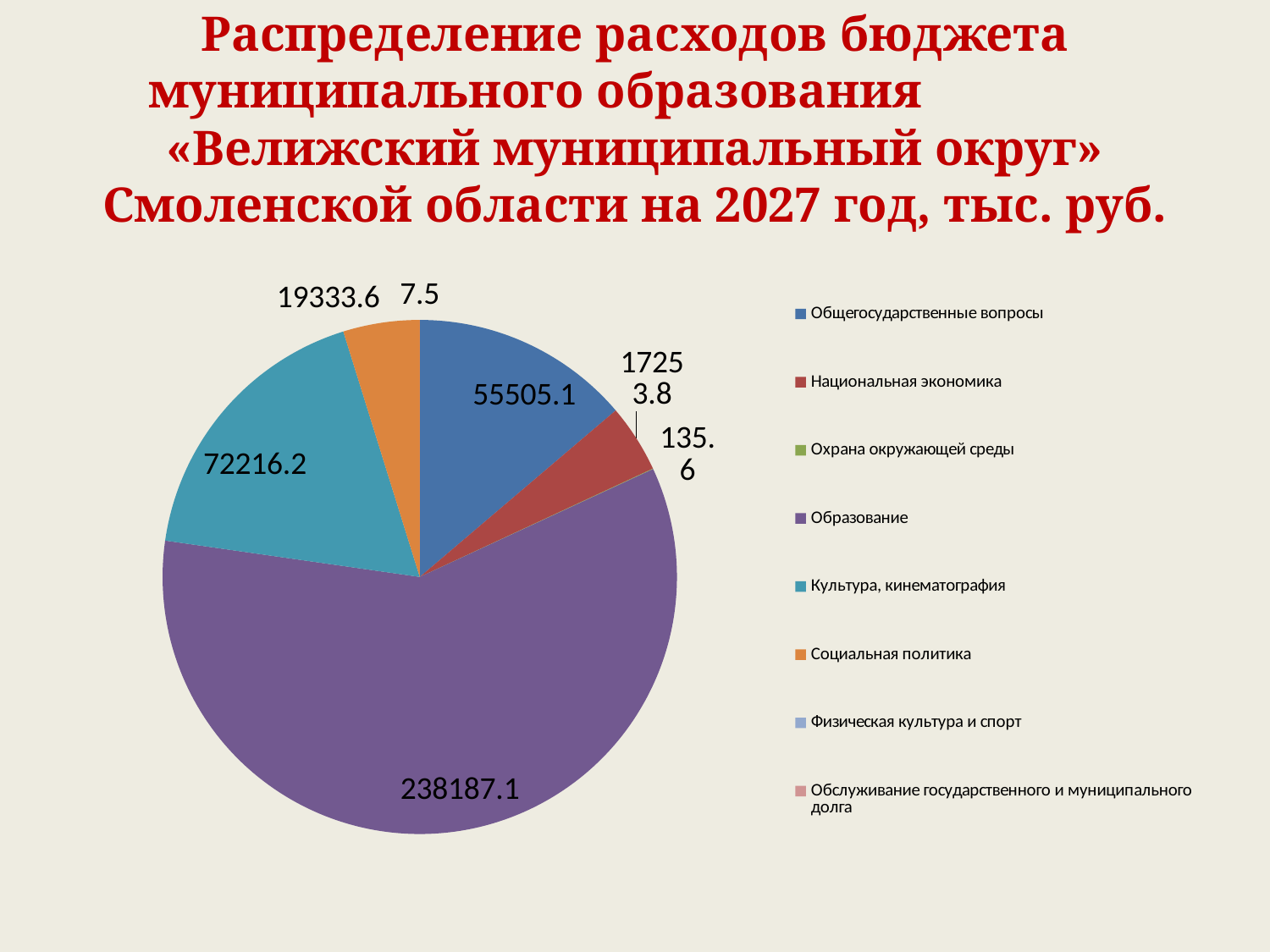
What is the value for Образование? 238187.1 What is the value for Социальная политика? 19333.6 What is the value for Национальная экономика? 17253.8 What is the difference between the values for Культура, кинематография and Общегосударственные вопросы? 16711.1 What is the value for Общегосударственные вопросы? 55505.1 What is the value for Культура, кинематография? 72216.2 Which category has the largest slice of the pie? Образование How many categories does the legend list? 8 What kind of chart is shown on the slide? pie chart Which is larger, Культура, кинематография or Общегосударственные вопросы? Культура, кинематография